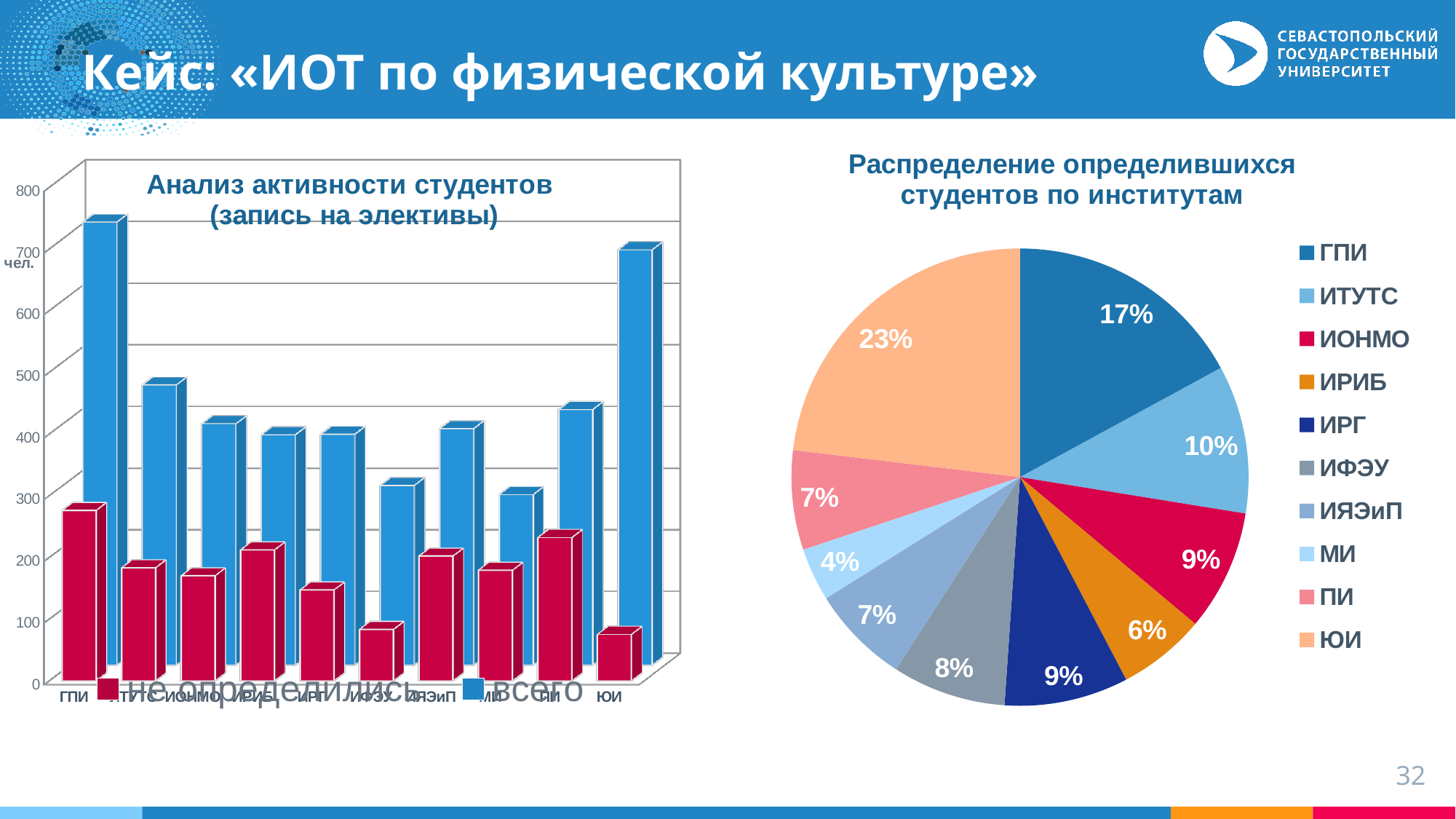
In the pie chart 'Распределение определившихся студентов по институтам', what share does ГПИ have? 17% In the pie chart 'Распределение определившихся студентов по институтам', which has the larger share, ИТУТС or ИРИБ? ИТУТС In the chart 'Анализ активности студентов (запись на элективы)', is the 'всего' value for ГПИ greater or less than 600? greater In the pie chart 'Распределение определившихся студентов по институтам', how many slices are there? 10 In the chart 'Анализ активности студентов (запись на элективы)', which institute has the highest 'всего' value? ГПИ What kind of chart is 'Анализ активности студентов (запись на элективы)'? bar chart In the pie chart 'Распределение определившихся студентов по институтам', how many percentage points larger is the ЮИ share than the ГПИ share? 6 In the pie chart 'Распределение определившихся студентов по институтам', which institute has the largest slice? ЮИ In the pie chart 'Распределение определившихся студентов по институтам', which institute has the smallest slice? МИ In the chart 'Анализ активности студентов (запись на элективы)', how many series does the legend list? 2 In the pie chart 'Распределение определившихся студентов по институтам', what share does ЮИ have? 23% In the chart 'Анализ активности студентов (запись на элективы)', how many institutes are shown on the x axis? 10